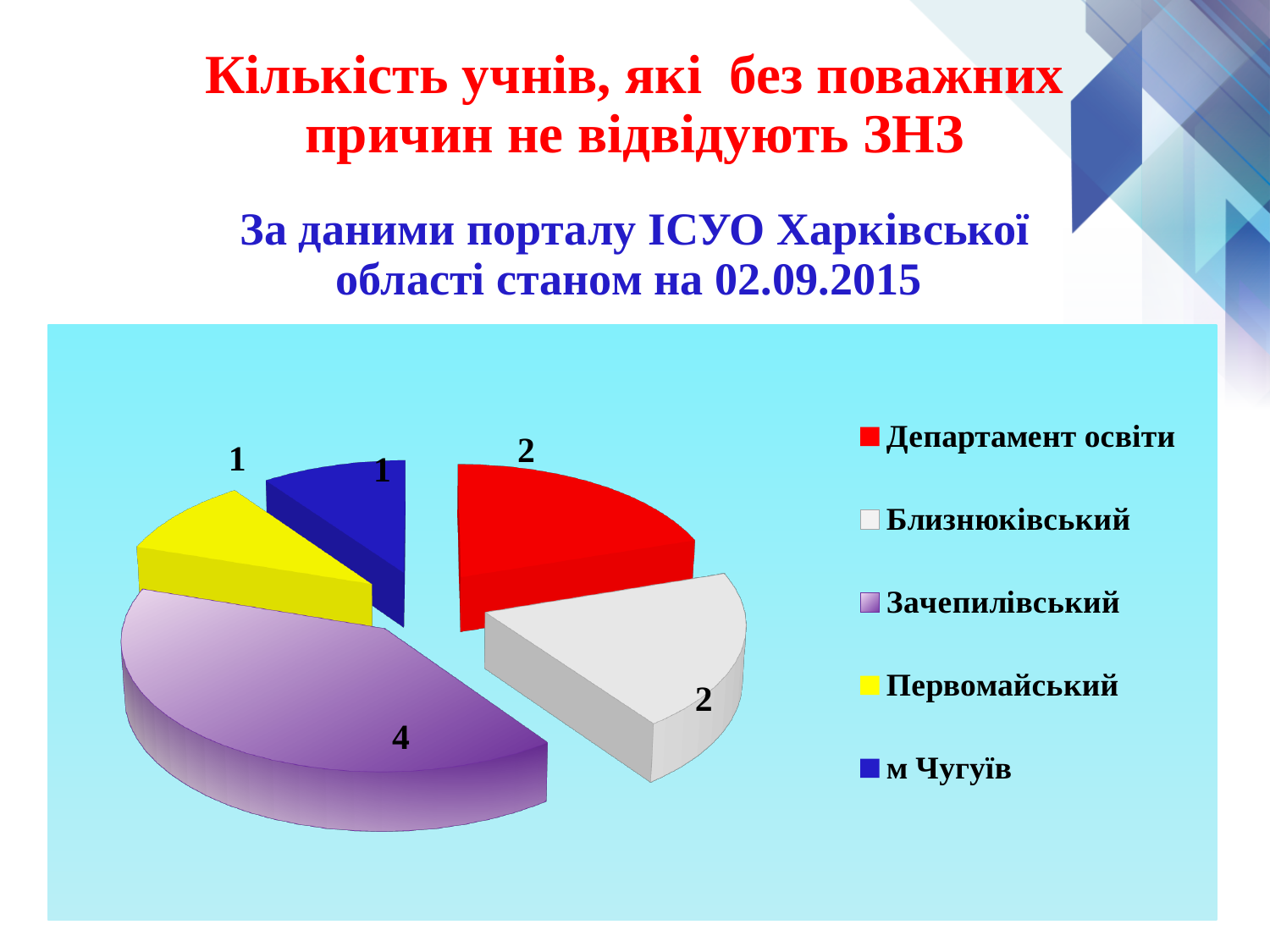
What is the value for Первомайський? 1 What is the value for Зачепилівський? 4 What is the value for м Чугуїв? 1 Which category has the largest slice of the pie? Зачепилівський Which is larger, the value for Зачепилівський or the value for Близнюківський? Зачепилівський Which colour represents Первомайський in the legend? yellow What share of the pie does Зачепилівський represent? 40% What type of chart is shown on the slide? pie chart What is the total of all slices in the pie chart? 10 What is the difference between the values for Зачепилівський and Департамент освіти? 2 What is the value for Департамент освіти? 2 How many categories does the pie chart have? 5